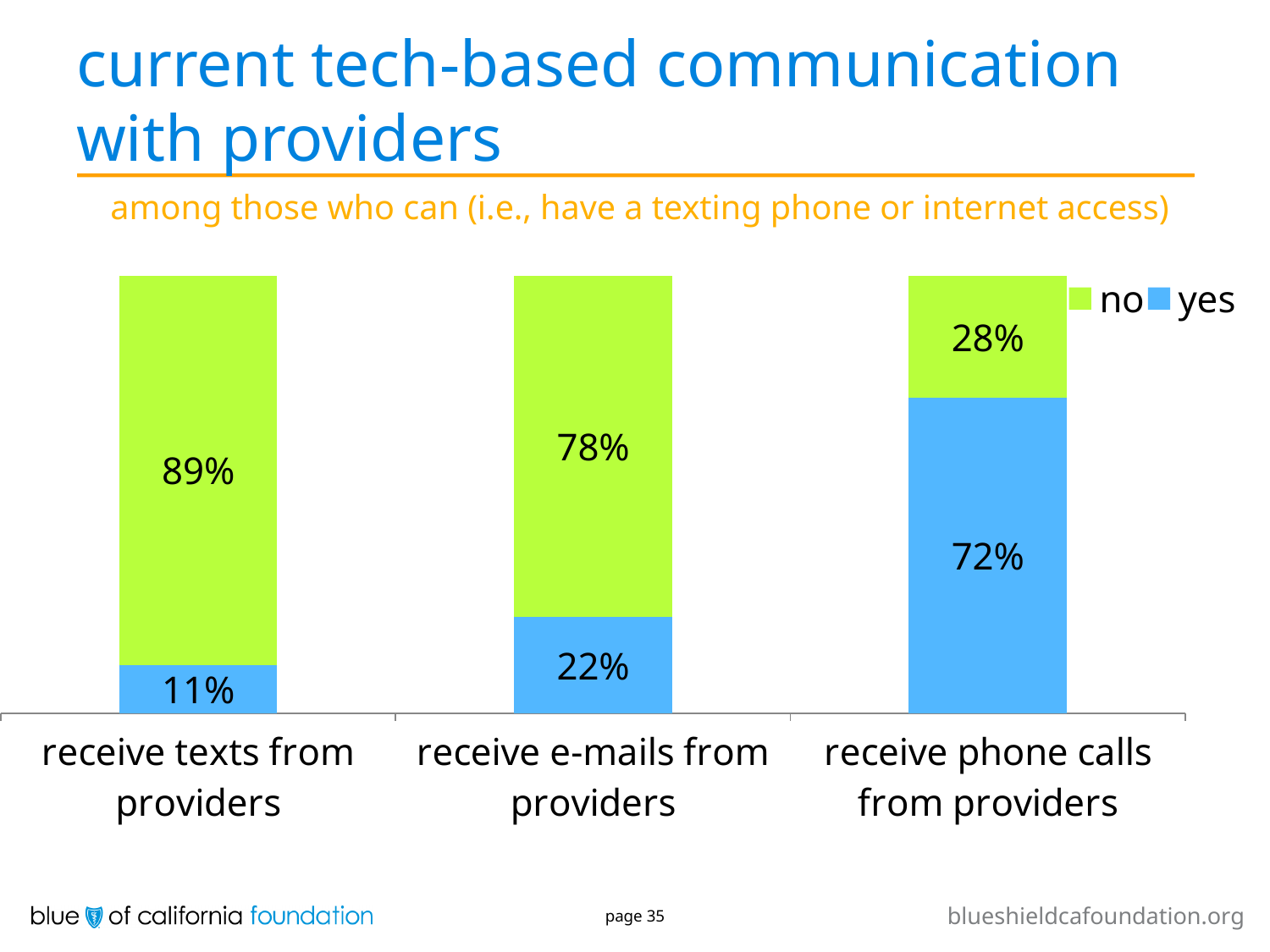
Which category has the highest 'yes' percentage? receive phone calls from providers Which category has the lowest 'yes' percentage? receive texts from providers Which is larger: the 'yes' percentage for receiving e-mails or the 'yes' percentage for receiving phone calls? receive phone calls from providers How many categories are shown on the x axis? 3 What is the difference between the 'no' percentage for receiving texts and the 'no' percentage for receiving e-mails? 11% What kind of chart is shown on the slide? stacked bar chart How many series does the legend list? 2 Which colour represents the 'no' series in the legend? green What is the total of the stacked bar for receiving phone calls from providers? 100% What percentage of respondents say 'yes' to receiving phone calls from providers? 72% What percentage of respondents say 'yes' to receiving texts from providers? 11% What percentage of respondents say 'no' to receiving e-mails from providers? 78%